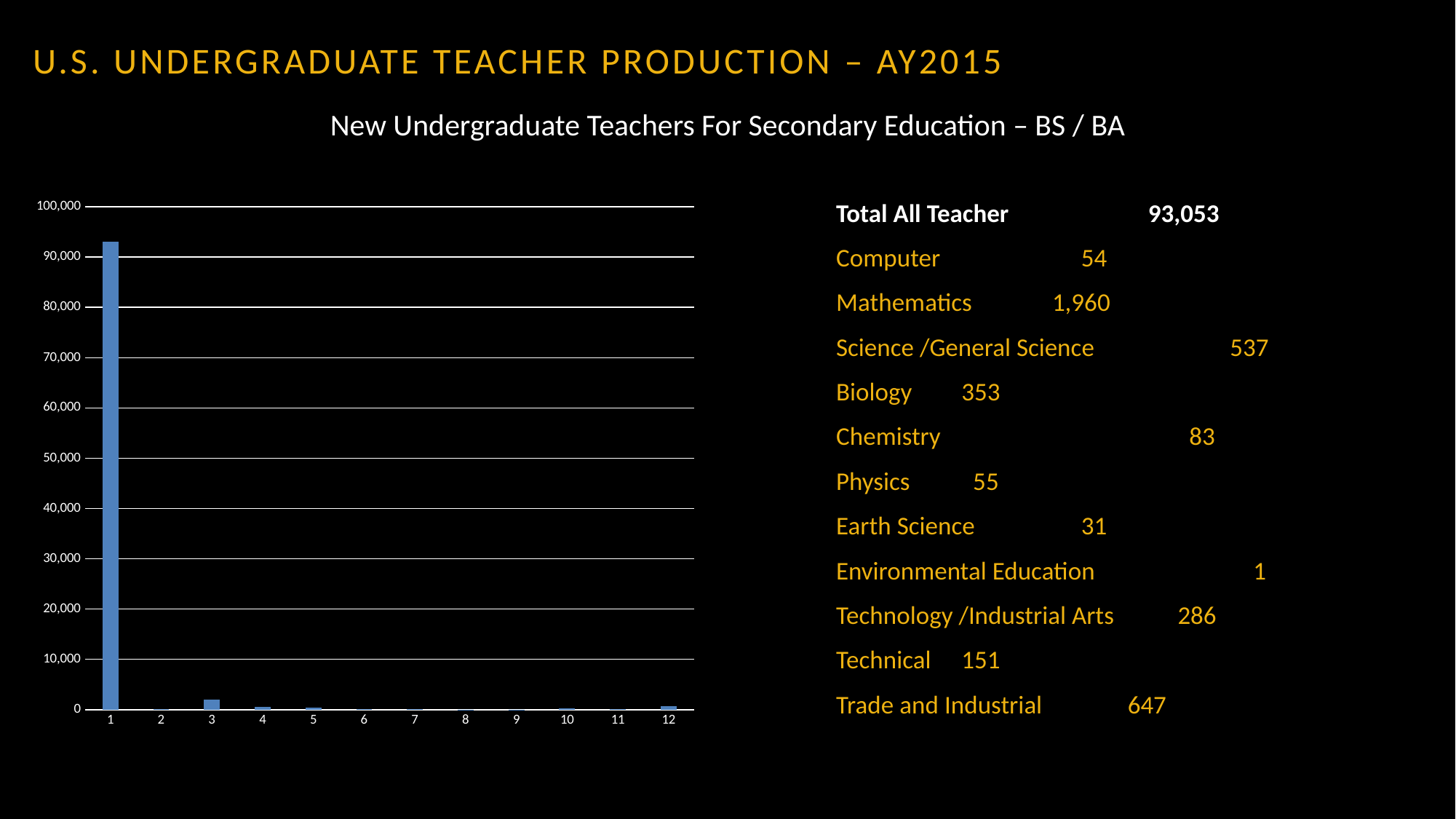
What is the title shown above the chart? New Undergraduate Teachers For Secondary Education – BS / BA What kind of chart is shown on the slide? bar chart Which category has the tallest bar in the chart? 1 Is the value for category 3 greater or less than 10,000? less Is the value for category 1 greater or less than 90,000? greater Which has the larger value, category 3 or category 12? 3 Which has the larger value, category 1 or category 3? 1 Is the value for category 1 greater or less than 100,000? less How many categories are plotted along the x axis of the chart? 12 What is the highest value shown on the chart's vertical axis? 100,000